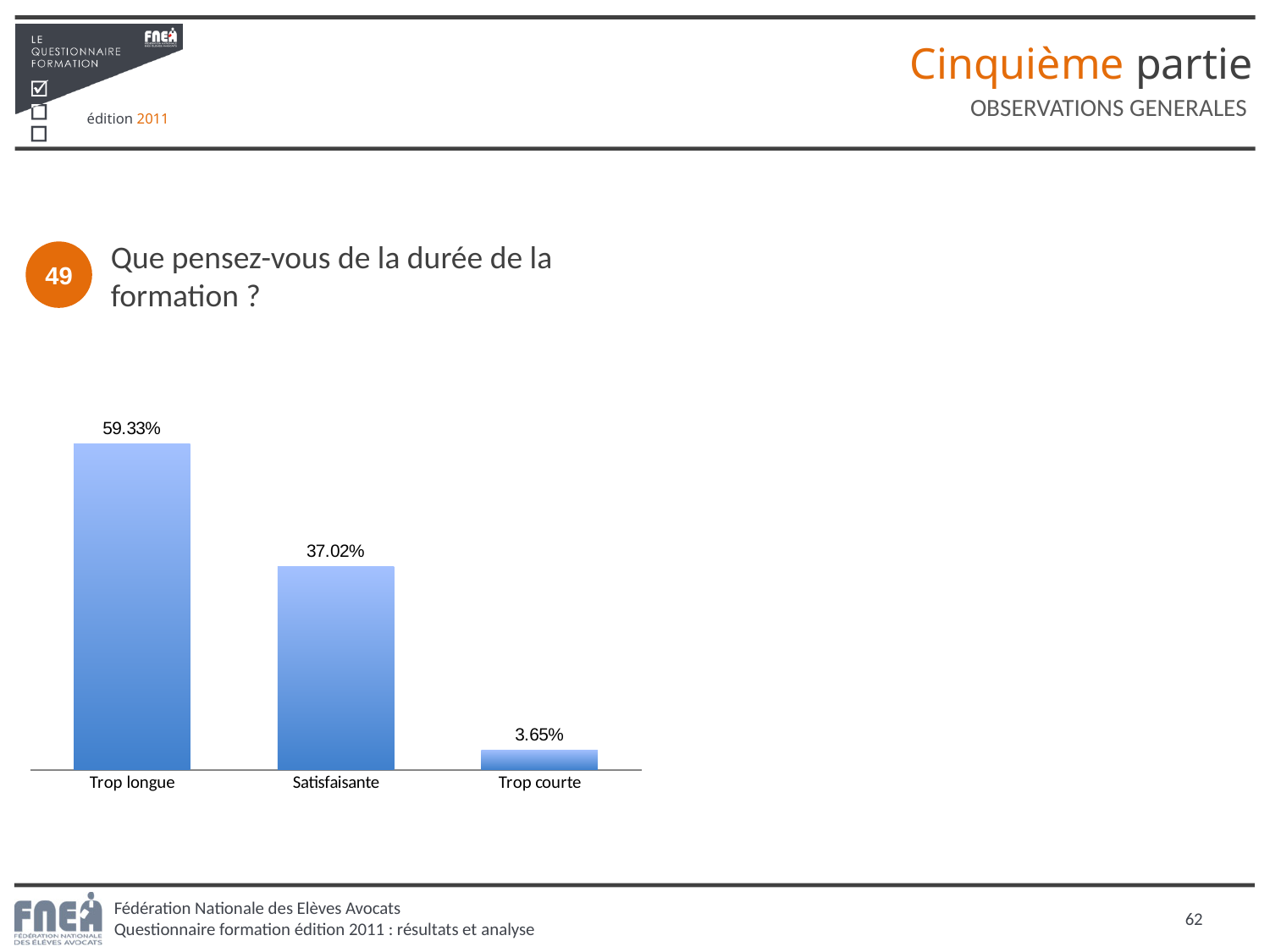
What is the difference between the values for "Trop longue" and "Satisfaisante"? 22.31% What kind of chart is shown on the slide? Bar chart Which category has the lowest value? Trop courte What is the value shown for "Trop courte"? 3.65% How many categories are shown in the chart? 3 What is the difference between the values for "Satisfaisante" and "Trop courte"? 33.37% Do the values rise or fall from left to right across the categories? Fall Which category has the highest value? Trop longue What is the value shown for "Satisfaisante"? 37.02% What question does the chart on the slide answer? Que pensez-vous de la durée de la formation ? What percentage of respondents answered "Trop longue"? 59.33% Which is larger, the value for "Satisfaisante" or the value for "Trop courte"? Satisfaisante